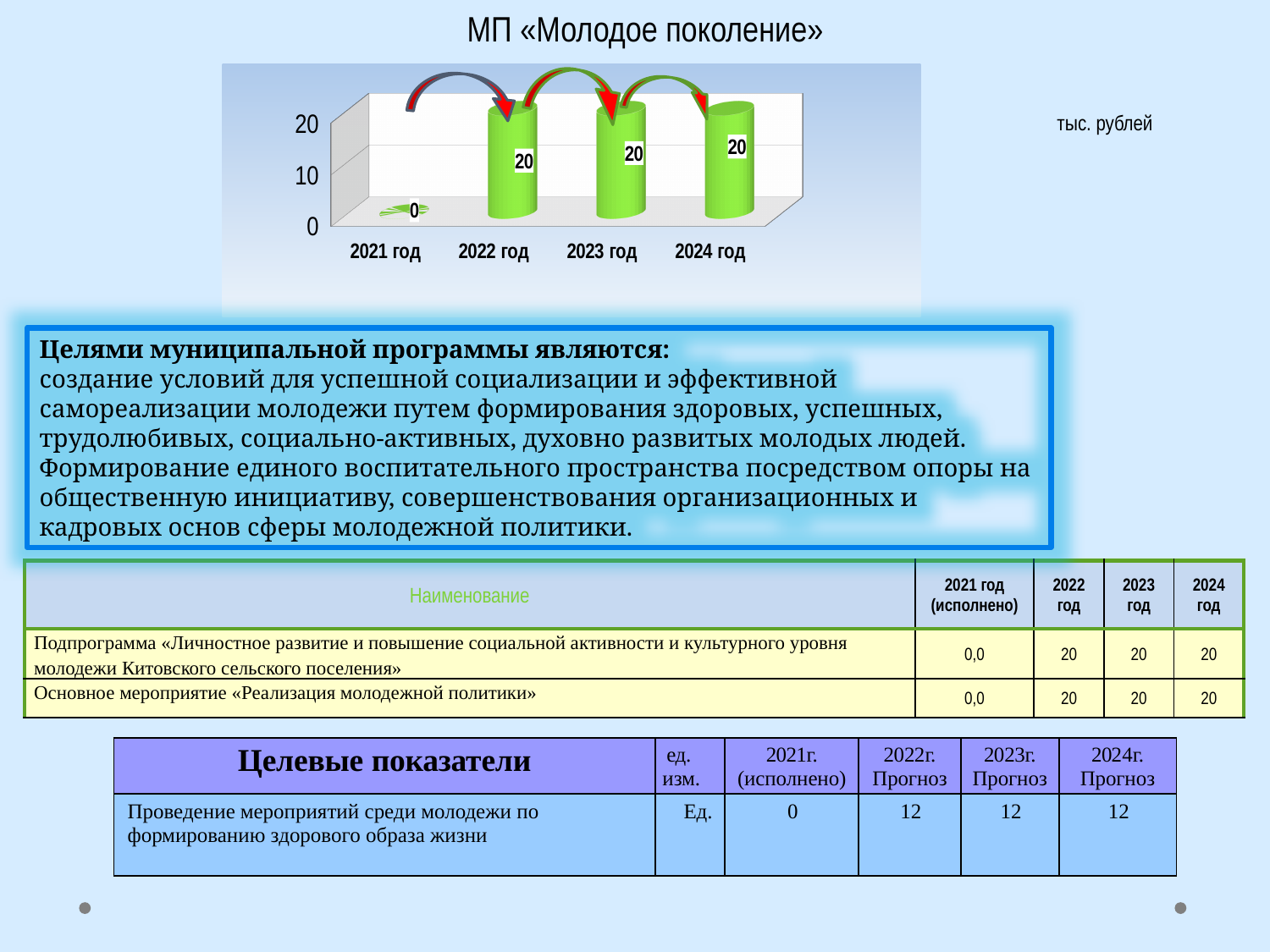
Do the values rise or fall from 2021 год to 2022 год? rise Which is larger, the value for 2023 год or the value for 2021 год? 2023 год What is the highest tick value shown on the vertical axis of the chart? 20 What unit is indicated next to the chart? тыс. рублей What is the value for 2024 год in the chart? 20 What is the value for 2022 год in the chart? 20 How many year categories are shown on the x axis of the chart? 4 Is the value for 2023 год greater or less than 10? greater What is the difference between the values for 2022 год and 2021 год? 20 What kind of chart is shown on the slide? bar chart Which year has the lowest value in the chart? 2021 год What is the value for 2021 год in the chart? 0